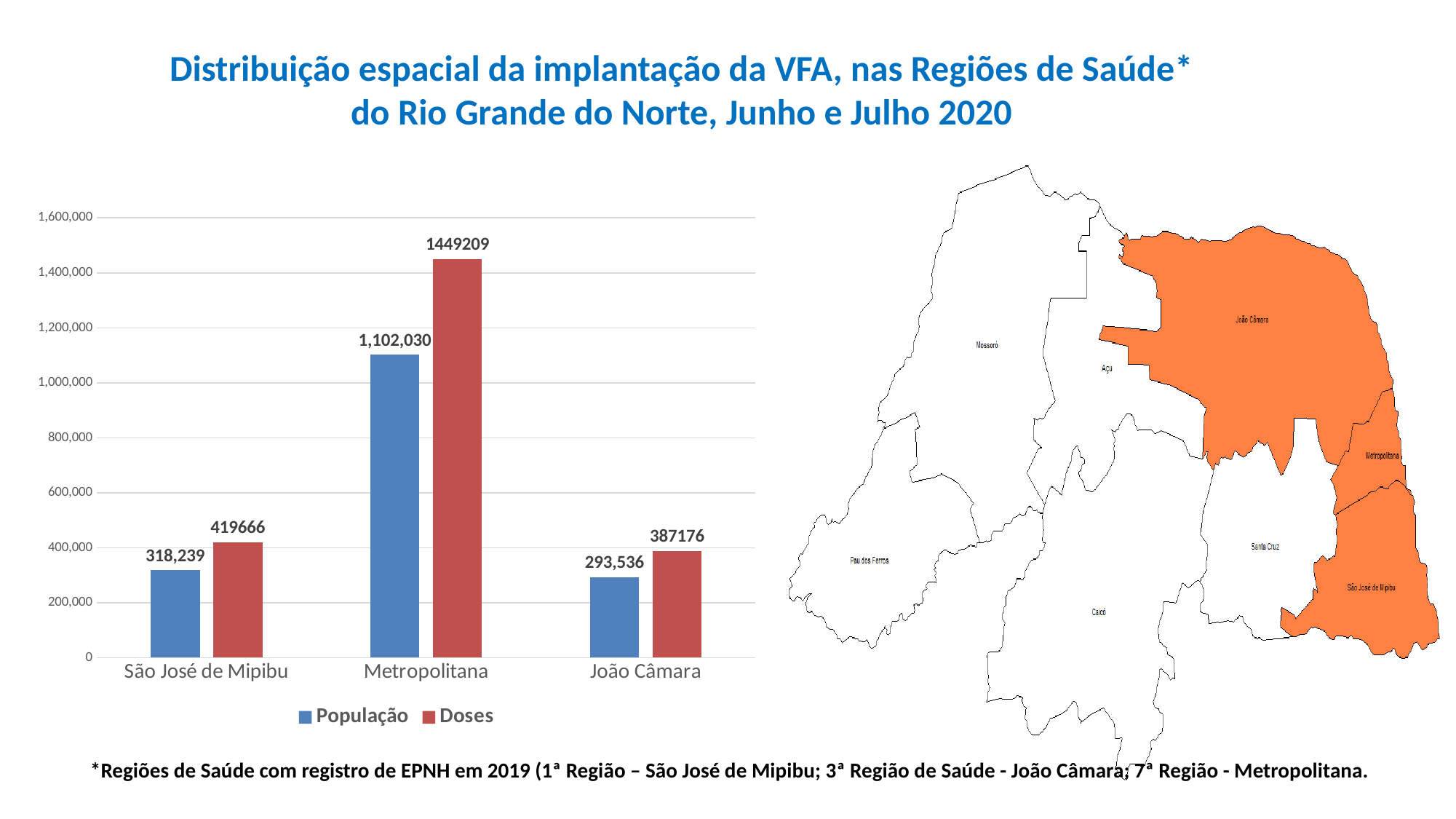
What is the Doses value for João Câmara? 387176 Which is larger for São José de Mipibu, População or Doses? Doses Which region has the lowest População value? João Câmara What is the Doses value for São José de Mipibu? 419666 What is the difference between the Doses values for Metropolitana and São José de Mipibu? 1029543 What is the difference between Doses and População for Metropolitana? 347179 How many regions are shown on the x axis of the bar chart? 3 How many series does the legend of the bar chart list? 2 Which region has the highest Doses value? Metropolitana What is the População value for João Câmara? 293,536 What is the População value for Metropolitana? 1,102,030 What kind of chart is shown on the left of the slide? Bar chart